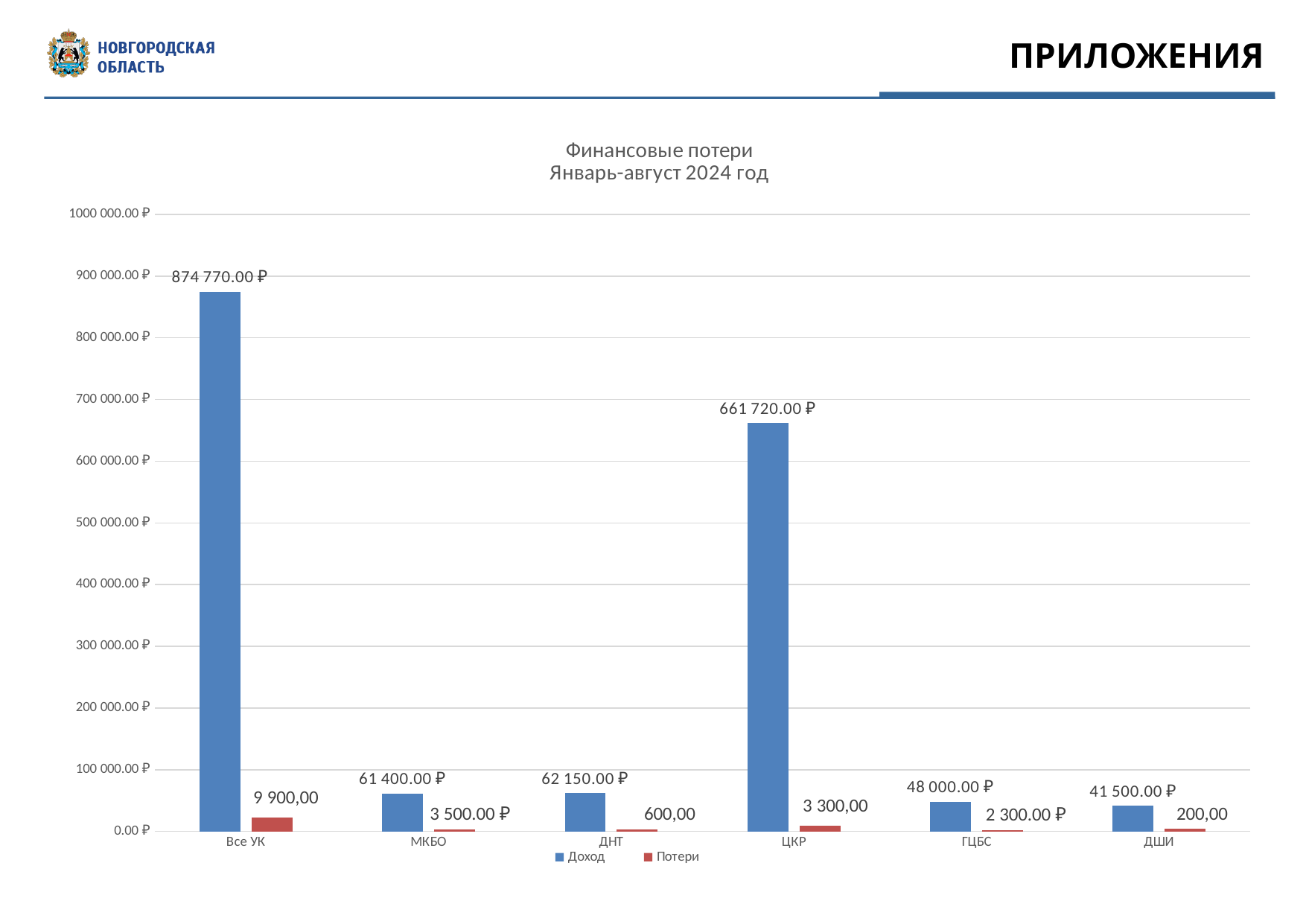
How many categories are shown on the x axis? 6 How many series does the legend list? 2 What is the Доход value for ЦКР? 661 720.00 ₽ Which has the larger Доход value, МКБО or ДНТ? ДНТ What is the difference between the Доход values for Все УК and ЦКР? 213 050.00 ₽ Which category has the lowest Доход value? ДШИ What kind of chart is shown on the slide? bar chart What is the Потери value for МКБО? 3 500.00 ₽ What is the Потери value for ДШИ? 200,00 Is the Доход value for ЦКР greater or less than 600 000.00 ₽? greater Which category has the highest Доход value? Все УК